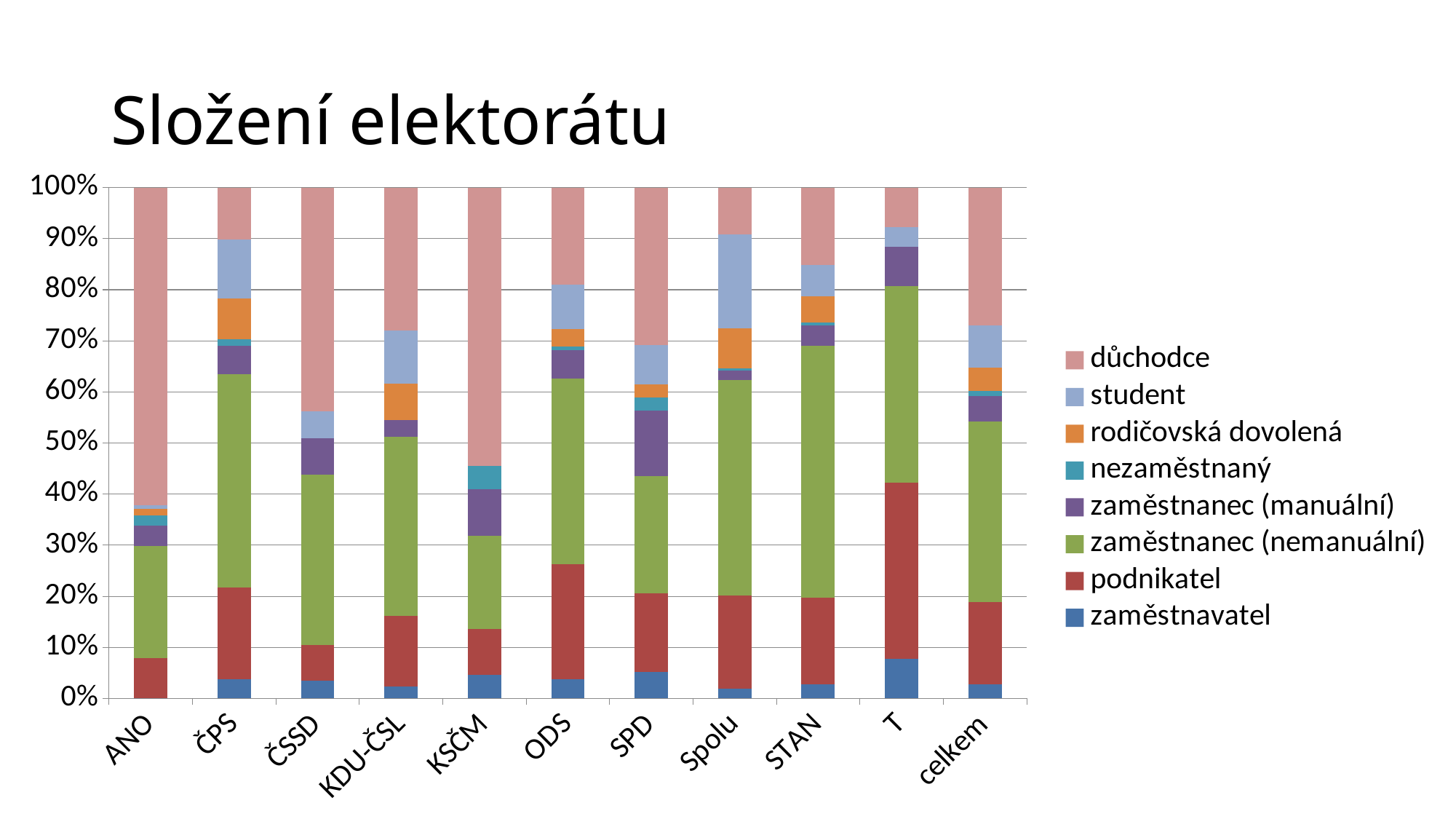
How many series does the legend list? 8 Is the podnikatel share for T greater or less than 30%? greater Which party has the largest podnikatel segment? T How many categories (parties) are shown along the x axis? 11 Which party has the largest student segment? Spolu What does each stacked bar total? 100% Which party has the largest důchodce segment? ANO Is the důchodce share for ANO greater or less than 50%? greater What kind of chart is shown on the slide? stacked bar chart Which legend entry is shown in the topmost (pink) segment of each bar? důchodce Which party has the smallest důchodce segment? T What is the title of the slide? Složení elektorátu